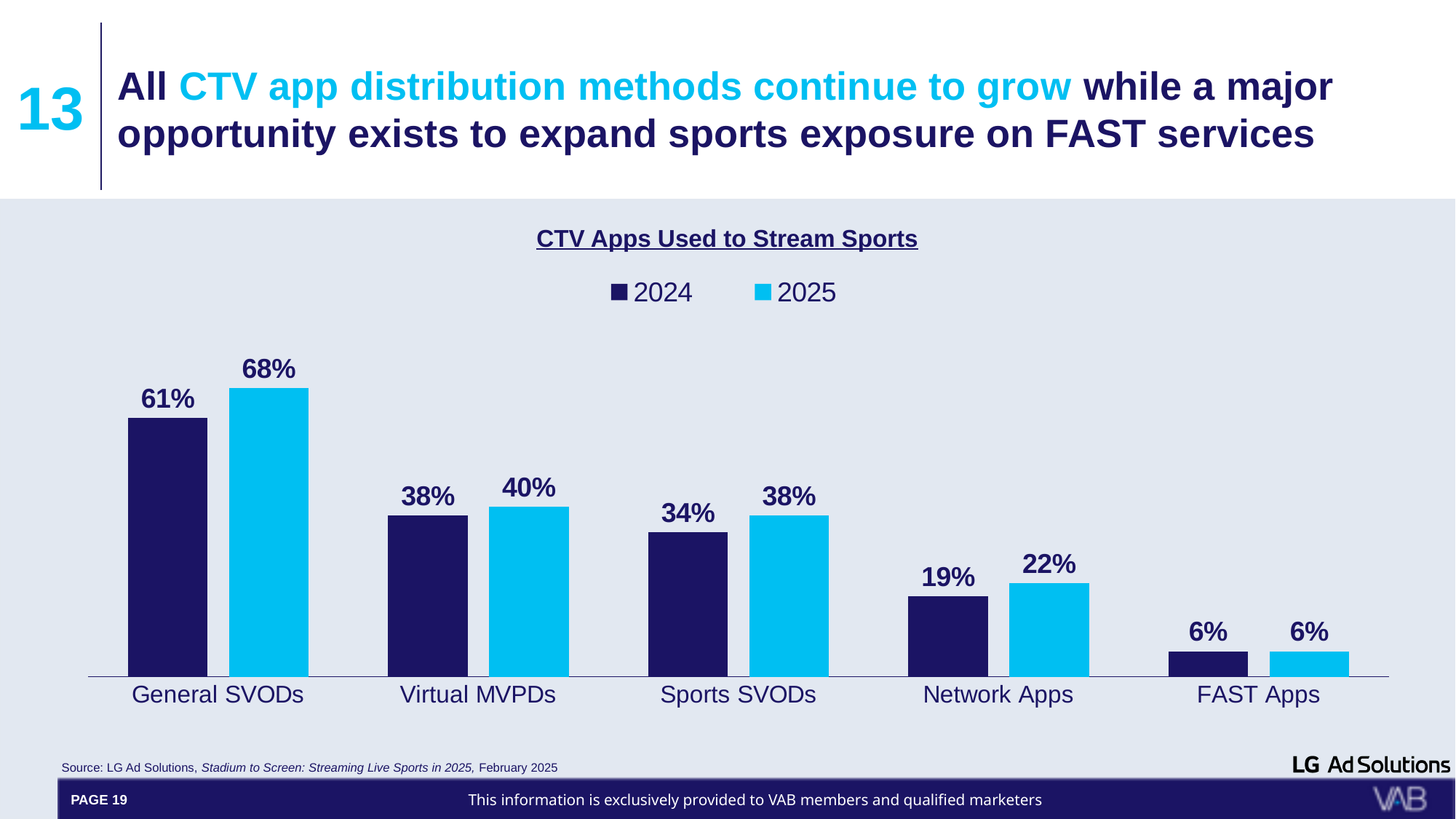
What is the 2025 value for Sports SVODs? 38% Which category has the highest 2025 value? General SVODs What is the difference between the 2025 and 2024 values for General SVODs? 7% Which category has the lowest 2024 value? FAST Apps What kind of chart is shown on the slide? Bar chart Which is larger, the 2024 value for Virtual MVPDs or the 2024 value for Sports SVODs? Virtual MVPDs What is the 2024 value for Network Apps? 19% How many categories are shown on the x axis? 5 How many series does the legend list? 2 What is the difference between the 2025 and 2024 values for Sports SVODs? 4% What is the 2025 value for General SVODs? 68% What is the title of the chart? CTV Apps Used to Stream Sports